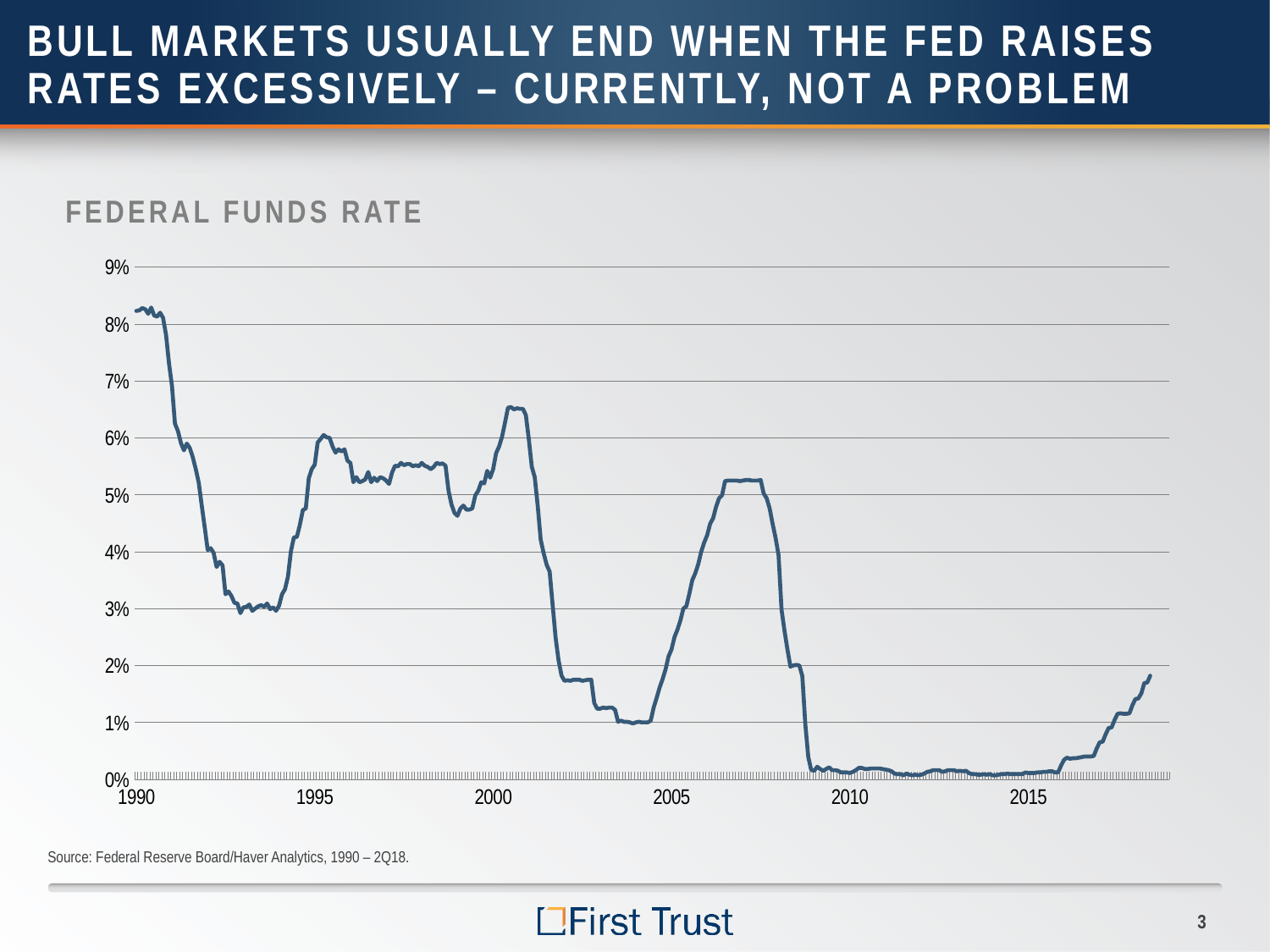
What is the highest value shown on the vertical axis? 9% Which is higher, the peak of the federal funds rate around 2000 or the peak around 2007? around 2000 Is the federal funds rate in 2010 greater or less than 1%? less Does the federal funds rate rise or fall between 2015 and the end of the series? rise Does the federal funds rate rise or fall between 2007 and 2009? fall Is the federal funds rate in 2005 greater or less than 4%? less What is the title of the chart? Federal Funds Rate What kind of chart is shown on the slide? line chart Is the federal funds rate in 2000 greater or less than 5%? greater Which is higher, the federal funds rate in 1990 or in 2000? 1990